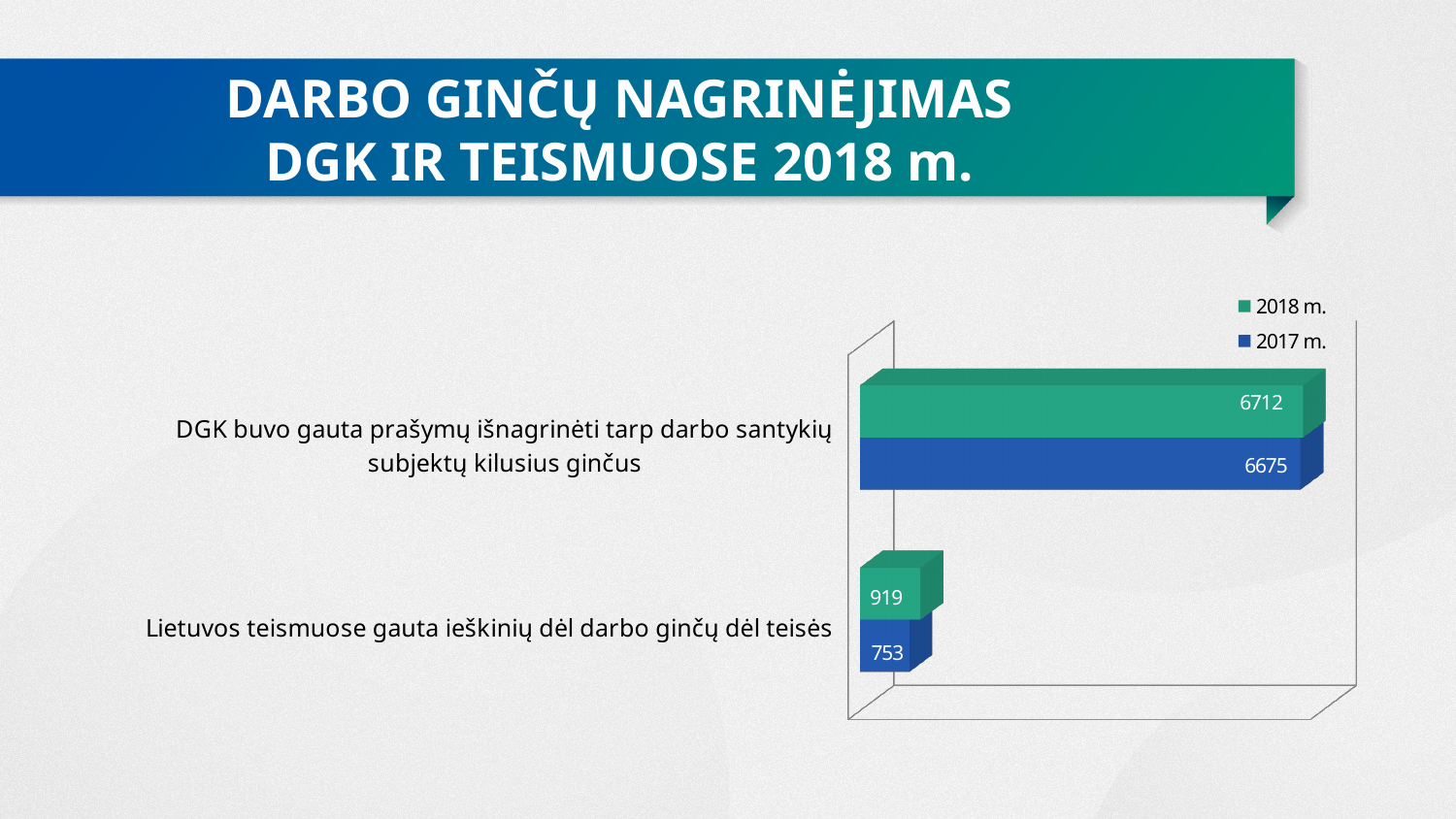
How many categories are plotted in the chart? 2 What is the 2018 m. value for "DGK buvo gauta prašymų išnagrinėti tarp darbo santykių subjektų kilusius ginčus"? 6712 What is the difference between the 2018 m. and 2017 m. values for "Lietuvos teismuose gauta ieškinių dėl darbo ginčų dėl teisės"? 166 What is the difference between the 2018 m. and 2017 m. values for "DGK buvo gauta prašymų išnagrinėti tarp darbo santykių subjektų kilusius ginčus"? 37 Which series is shown in green in the chart? 2018 m. What is the 2017 m. value for "Lietuvos teismuose gauta ieškinių dėl darbo ginčų dėl teisės"? 753 What is the 2018 m. value for "Lietuvos teismuose gauta ieškinių dėl darbo ginčų dėl teisės"? 919 Which category has the lowest 2017 m. value? Lietuvos teismuose gauta ieškinių dėl darbo ginčų dėl teisės What is the 2017 m. value for "DGK buvo gauta prašymų išnagrinėti tarp darbo santykių subjektų kilusius ginčus"? 6675 Which category has the highest 2018 m. value? DGK buvo gauta prašymų išnagrinėti tarp darbo santykių subjektų kilusius ginčus How many series does the chart legend list? 2 What kind of chart is shown on the slide? bar chart